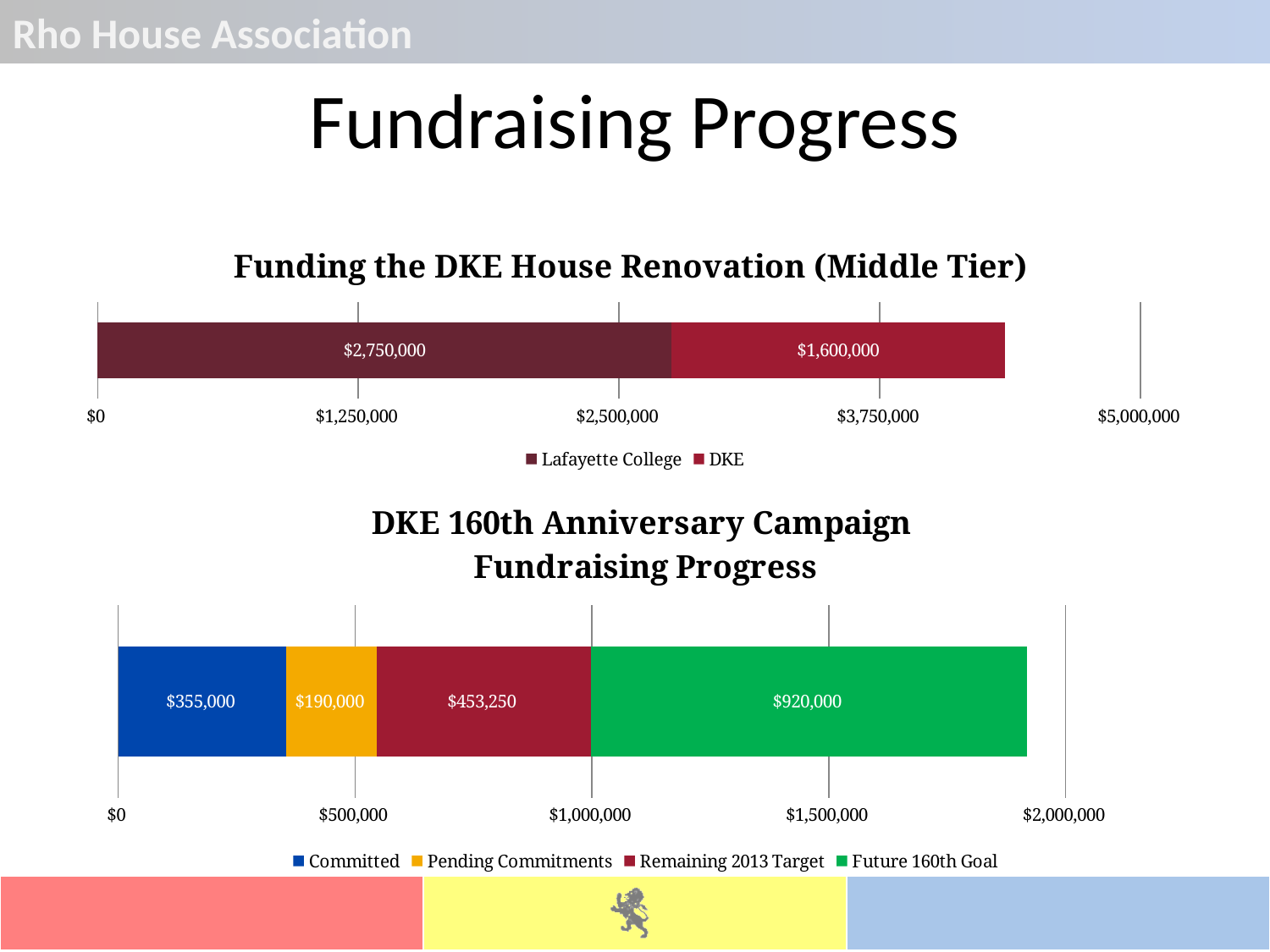
What kind of chart is the 'DKE 160th Anniversary Campaign Fundraising Progress' chart? Stacked bar chart In the 'DKE 160th Anniversary Campaign Fundraising Progress' chart, what is the difference between Future 160th Goal and Committed? $565,000 In the 'DKE 160th Anniversary Campaign Fundraising Progress' chart, which series has the smallest value? Pending Commitments In the 'Funding the DKE House Renovation (Middle Tier)' chart, how much larger is the Lafayette College value than the DKE value? $1,150,000 In the 'DKE 160th Anniversary Campaign Fundraising Progress' chart, what is the total of the stacked bar? $1,918,250 In the 'Funding the DKE House Renovation (Middle Tier)' chart, what is the value for Lafayette College? $2,750,000 In the 'DKE 160th Anniversary Campaign Fundraising Progress' chart, which series has the largest value? Future 160th Goal In the 'Funding the DKE House Renovation (Middle Tier)' chart, what is the total of the stacked bar? $4,350,000 In the 'DKE 160th Anniversary Campaign Fundraising Progress' chart, what is the value for Committed? $355,000 In the 'Funding the DKE House Renovation (Middle Tier)' chart, what is the value for DKE? $1,600,000 How many series does the legend of the 'Funding the DKE House Renovation (Middle Tier)' chart list? 2 In the 'DKE 160th Anniversary Campaign Fundraising Progress' chart, what is the value for Remaining 2013 Target? $453,250